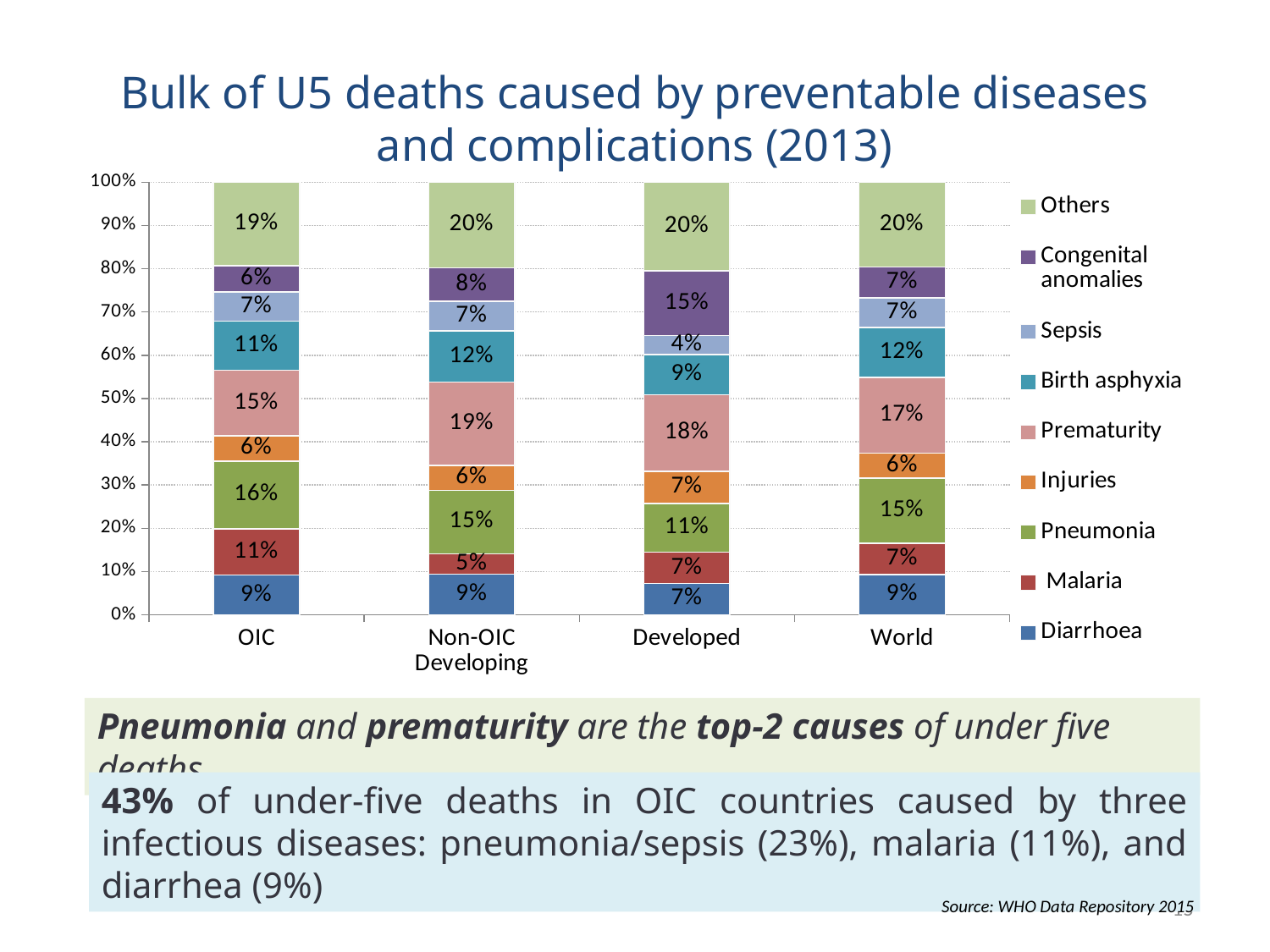
Which legend entry is shown in light green at the top of each bar? Others What is the Congenital anomalies share for Developed? 15% What is the Prematurity share for Non-OIC Developing? 19% What is the difference between the Congenital anomalies share for Developed and for OIC? 9% Which category has the highest Malaria share? OIC What is the Pneumonia share for OIC? 16% What is the Malaria share for World? 7% How many categories are shown on the x axis? 4 What kind of chart is shown on the slide? Stacked bar chart Which is larger: the Prematurity share for OIC or for World? World How many series does the legend list? 9 Which category has the lowest Sepsis share? Developed